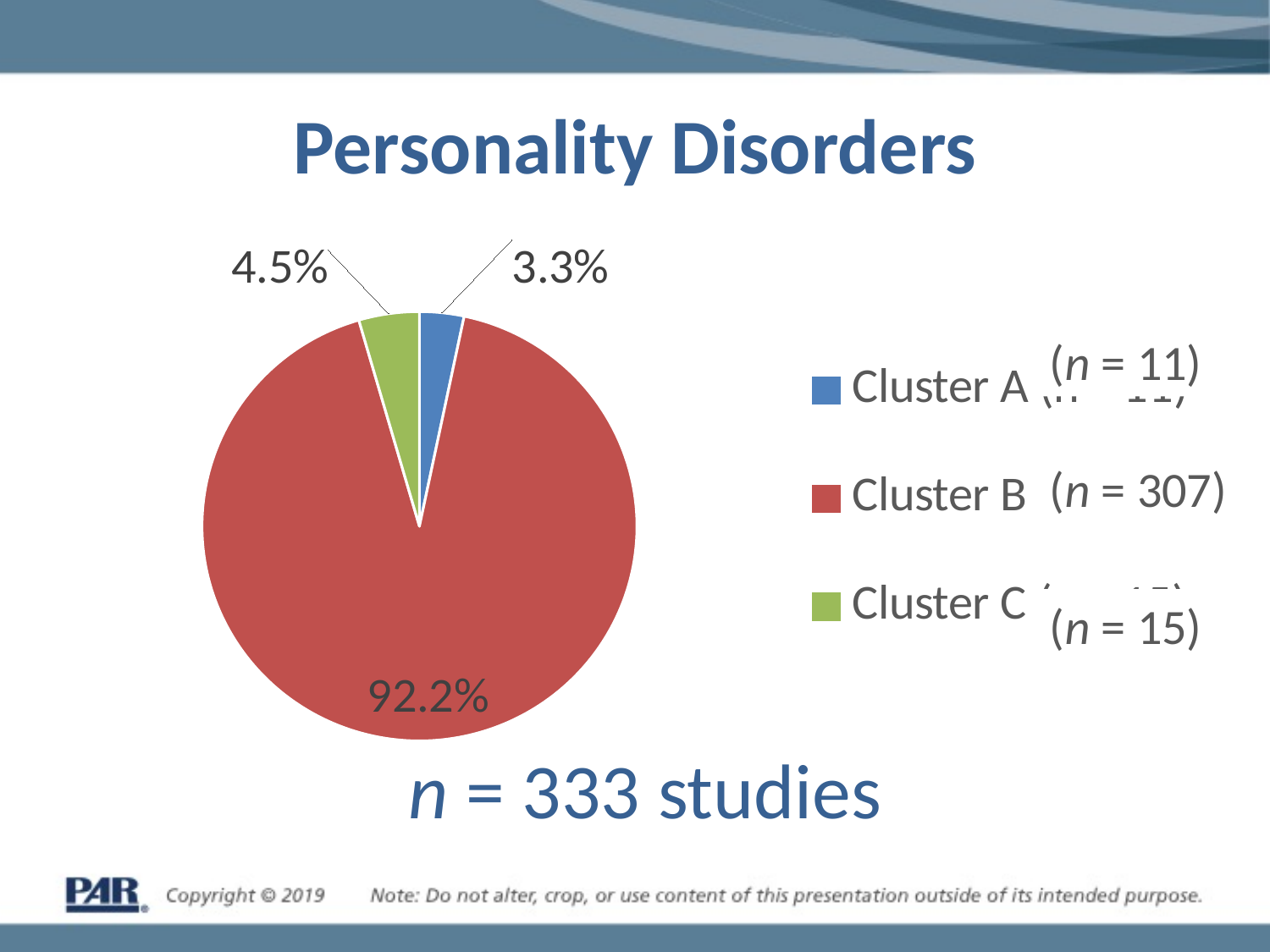
What is the difference in percentage points between the Cluster C and Cluster A shares? 1.2% What percentage of the pie does Cluster B represent? 92.2% What is the title of the chart? Personality Disorders Which cluster has the largest share of the pie? Cluster B Which cluster has the smallest share of the pie? Cluster A How many slices does the pie chart have? 3 What percentage of the pie does Cluster C represent? 4.5% How many entries does the legend list? 3 What colour is the Cluster B slice? red What percentage of the pie does Cluster A represent? 3.3% What kind of chart is shown on the slide? pie chart Which has a larger share of the pie, Cluster A or Cluster C? Cluster C